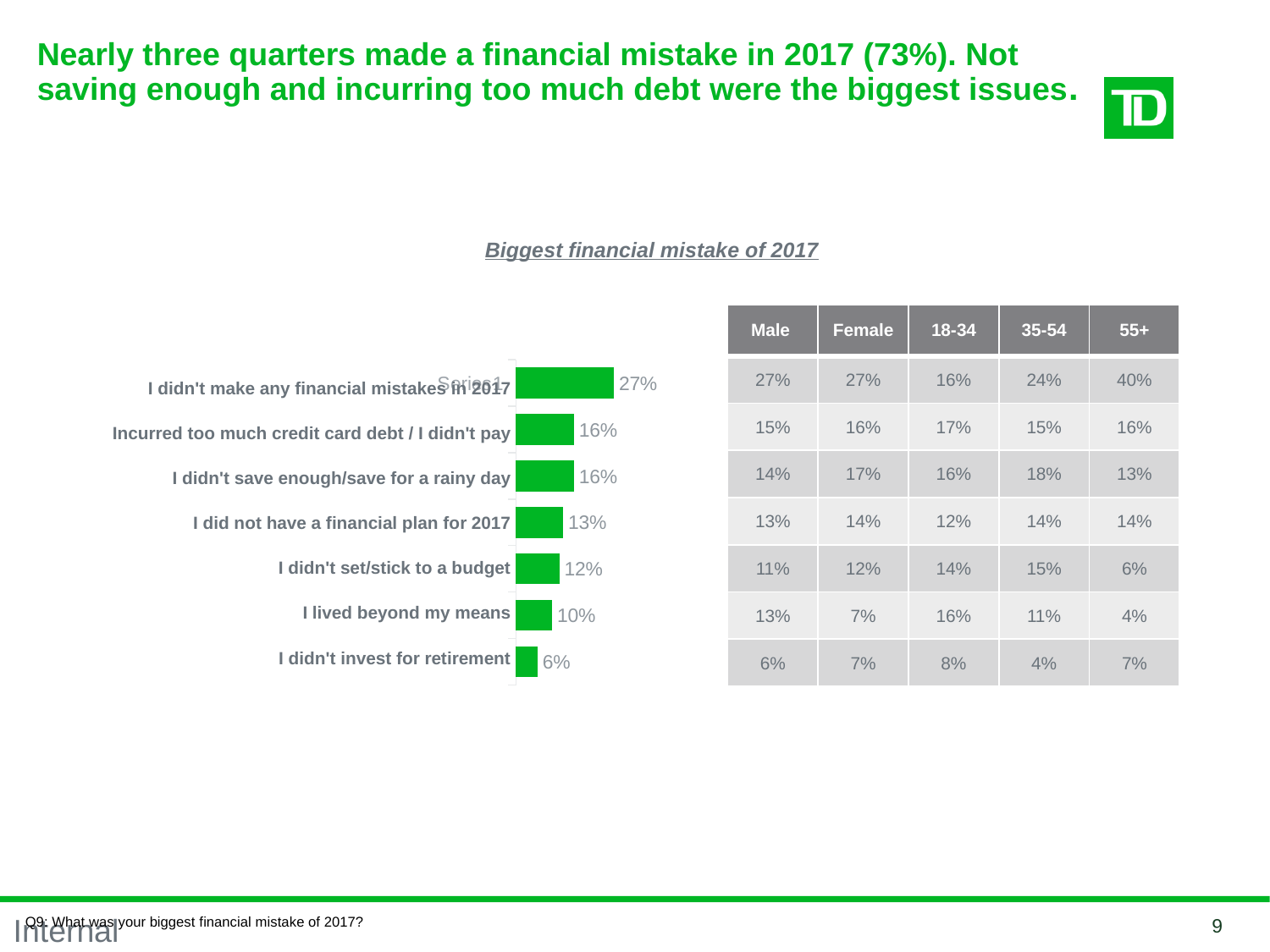
Which is larger: 'I lived beyond my means' or 'I didn't set/stick to a budget'? I didn't set/stick to a budget How many categories are shown in the bar chart? 7 What is the value for 'I did not have a financial plan for 2017'? 13% What is the value for 'I lived beyond my means'? 10% What type of chart is shown on the slide? Bar chart What colour are the bars in the chart? Green Which category has the lowest value in the bar chart? I didn't invest for retirement Which category has the highest value in the bar chart? I didn't make any financial mistakes in 2017 What is the value for 'I didn't invest for retirement'? 6% What is the title of the chart? Biggest financial mistake of 2017 What is the difference between 'I didn't make any financial mistakes in 2017' and 'I didn't set/stick to a budget'? 15% What percentage of respondents said they didn't make any financial mistakes in 2017? 27%